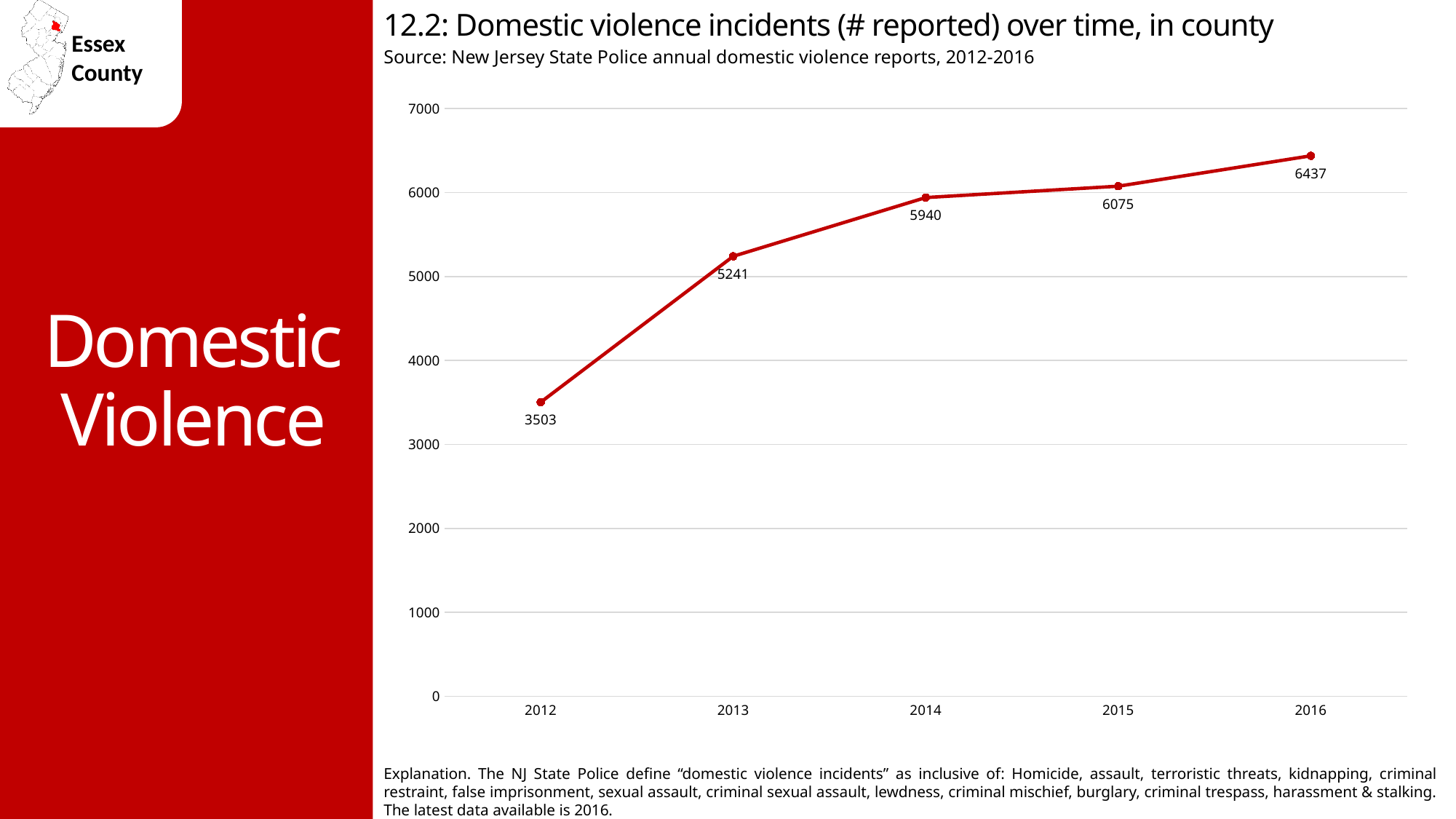
What is the difference in reported incidents between 2016 and 2015? 362 What is the difference in reported incidents between 2013 and 2012? 1738 What was the number of reported domestic violence incidents in 2016? 6437 Do reported domestic violence incidents rise or fall from 2012 to 2016? rise Which year had the highest number of reported domestic violence incidents? 2016 What was the number of reported domestic violence incidents in 2012? 3503 Which year had the lowest number of reported domestic violence incidents? 2012 Which year had more reported incidents, 2014 or 2015? 2015 What kind of chart is shown on the slide? line chart How many years are plotted on the chart? 5 Is the value for 2013 greater or less than 5000? greater What was the number of reported domestic violence incidents in 2014? 5940